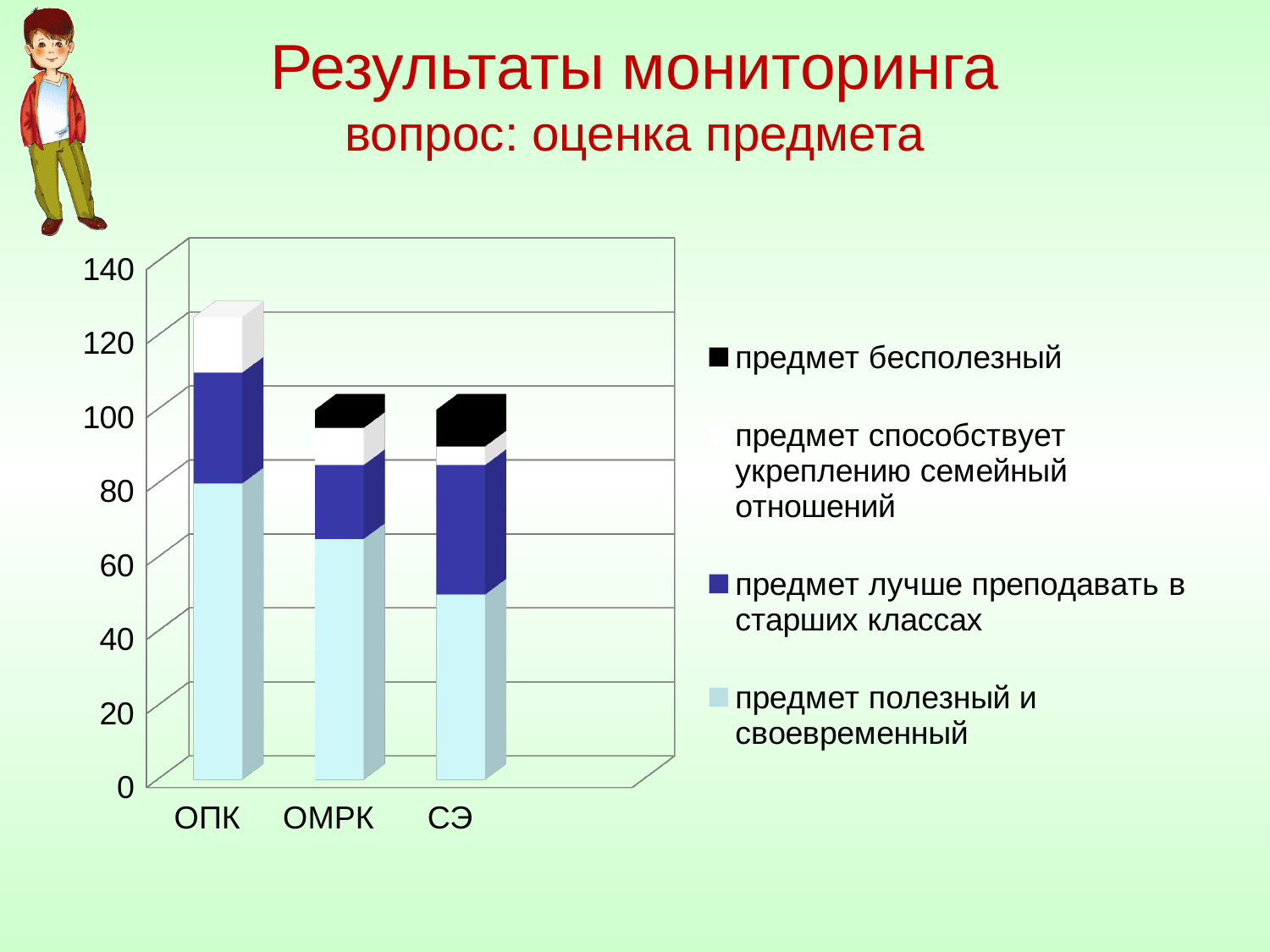
Is the value for 'предмет полезный и своевременный' for СЭ greater or less than 60? less Which category has the tallest stacked bar overall? ОПК Which category has the smallest value for 'предмет полезный и своевременный'? СЭ Which legend entry is shown in black? предмет бесполезный Which is larger: the 'предмет полезный и своевременный' value for ОПК or for СЭ? ОПК What kind of chart is shown on the slide? Stacked bar chart How many categories are shown on the x axis of the chart? 3 Does the value for 'предмет полезный и своевременный' rise or fall from ОПК to СЭ along the x axis? fall Is the value for 'предмет полезный и своевременный' for ОПК greater or less than 60? greater Is the total of the stacked bar for СЭ greater or less than 120? less Which category has the largest value for 'предмет полезный и своевременный'? ОПК How many series does the chart legend list? 4